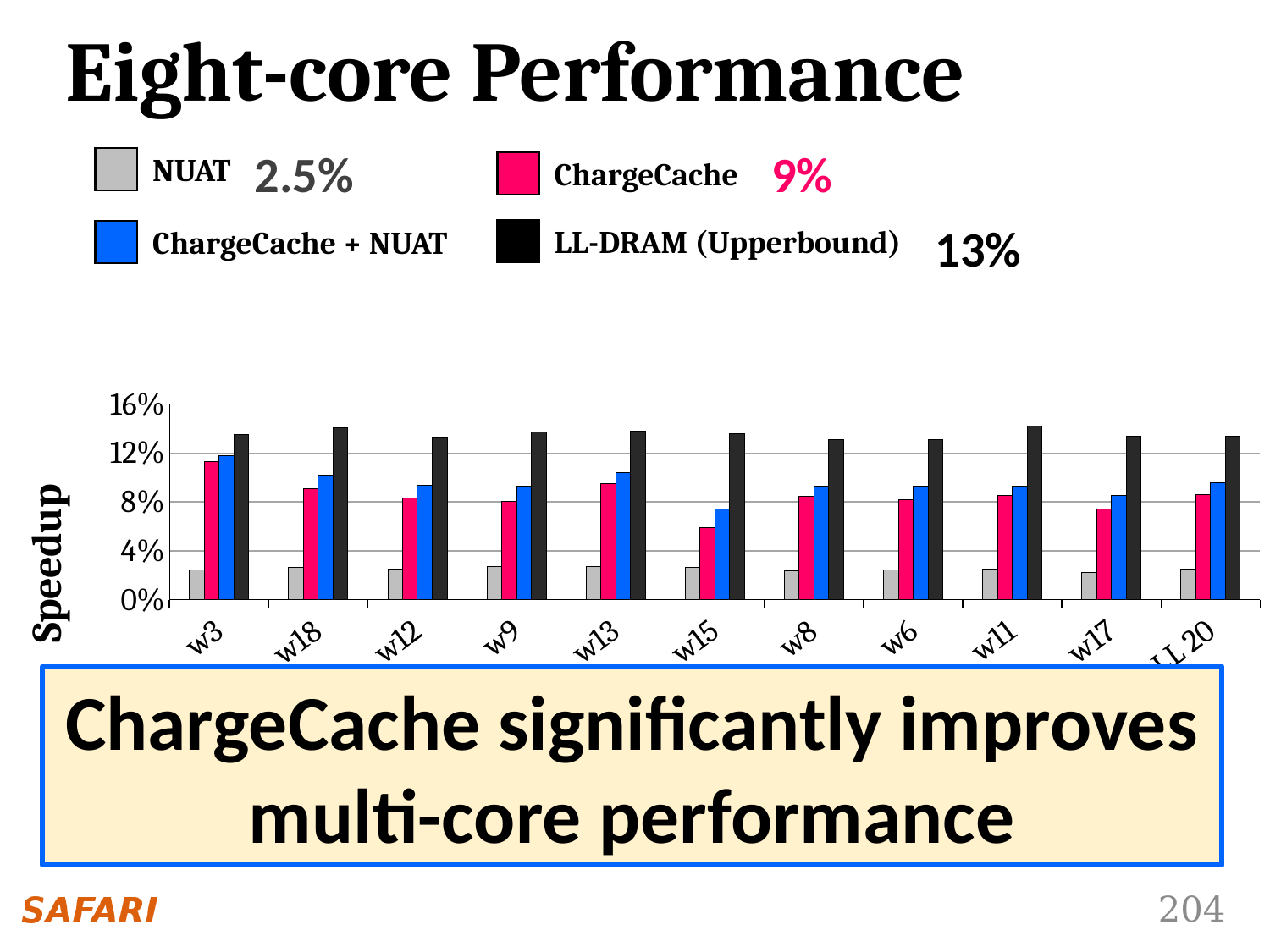
Is the LL-DRAM (Upperbound) speedup for w18 greater or less than 12%? greater Is the ChargeCache speedup for w15 greater or less than 8%? less Which is larger for w3: the LL-DRAM (Upperbound) speedup or the NUAT speedup? LL-DRAM (Upperbound) How many series does the legend list? 4 Which workload has the lowest ChargeCache speedup? w15 How many workload groups are plotted along the x axis? 11 Which workload has the highest ChargeCache speedup? w3 What average speedup is printed next to ChargeCache in the legend? 9% What kind of chart is shown on the slide? bar chart What is the label of the y axis? Speedup Is the NUAT speedup for w3 greater or less than 4%? less